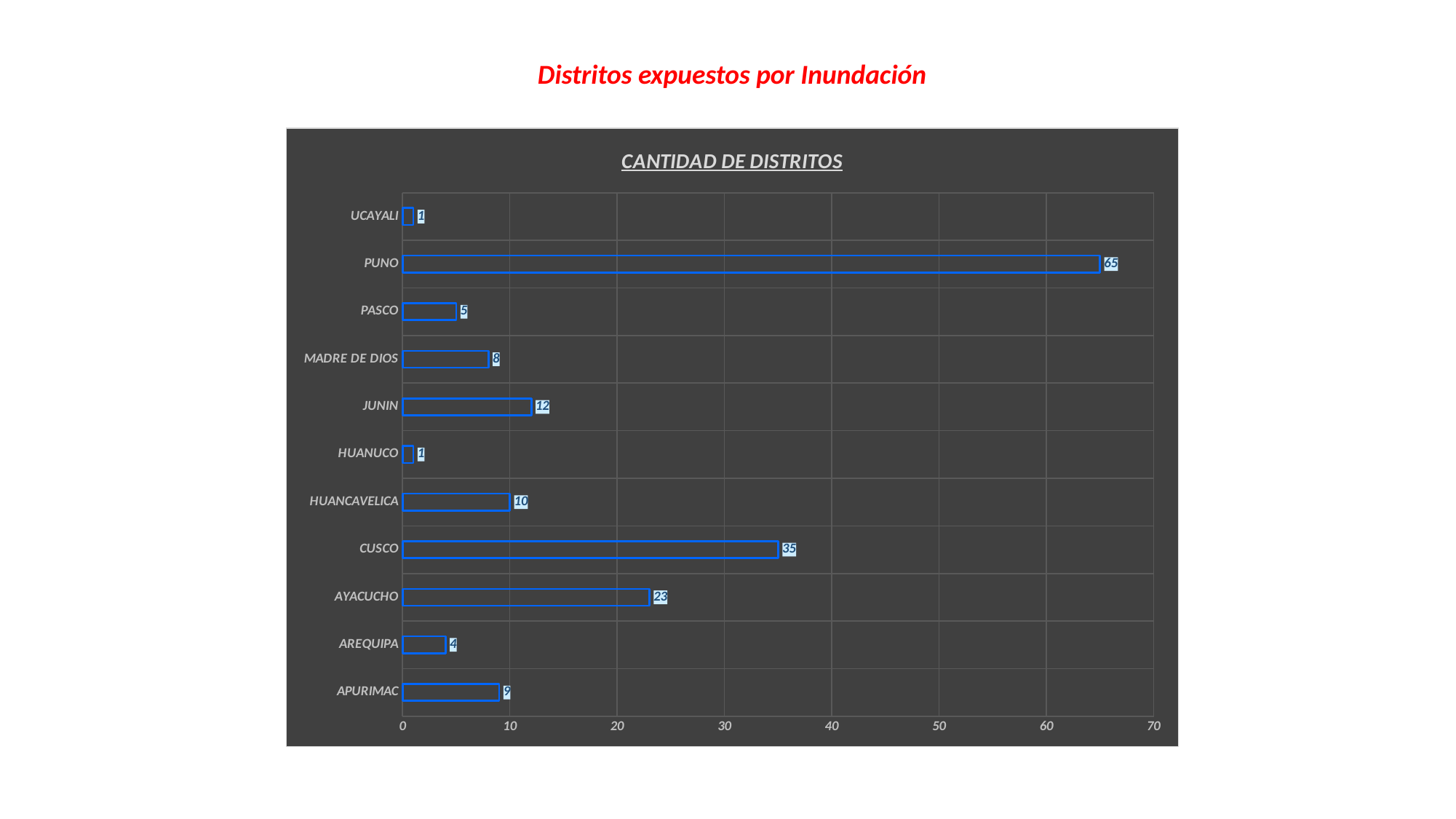
What is the value for PUNO? 65 What is the difference between the values for JUNIN and MADRE DE DIOS? 4 What is the difference between the values for PUNO and CUSCO? 30 How many categories are shown on the chart? 11 What is the title of the chart? CANTIDAD DE DISTRITOS Which is larger, the value for APURIMAC or the value for PASCO? APURIMAC Which category has the highest value? PUNO What is the value for HUANCAVELICA? 10 What kind of chart is shown on the slide? Bar chart Which is larger, the value for AYACUCHO or the value for JUNIN? AYACUCHO What is the value for CUSCO? 35 What is the value for AYACUCHO? 23